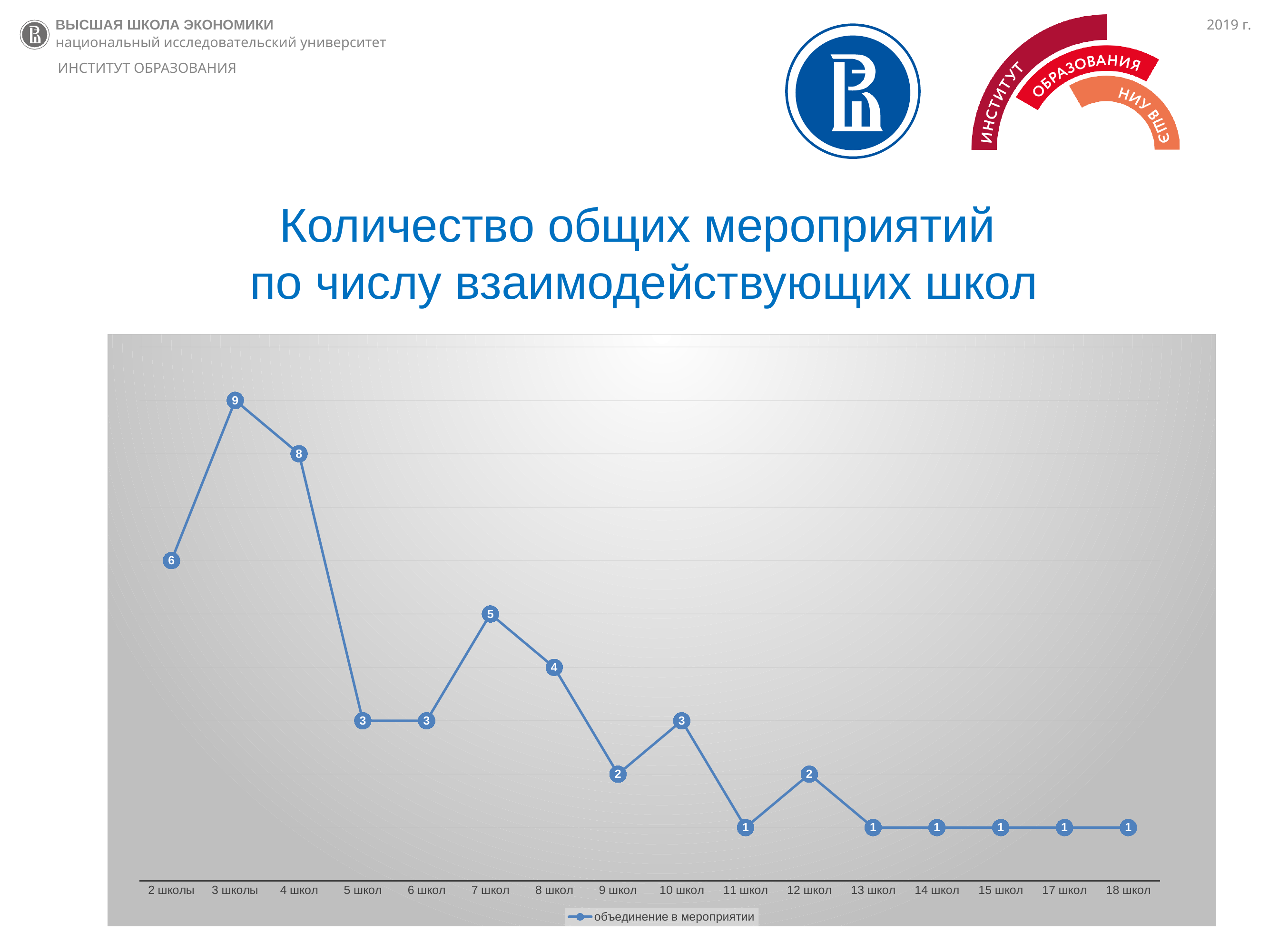
What is the value for "3 школы"? 9 Which category has the highest value? 3 школы How many categories are shown on the x axis? 16 What kind of chart is shown on the slide? line chart What is the legend entry for the series? объединение в мероприятии What is the difference between the values for "3 школы" and "4 школ"? 1 What is the value for "2 школы"? 6 Do the values generally rise or fall from "4 школ" to "18 школ"? fall How many series does the legend list? 1 What is the difference between the values for "2 школы" and "5 школ"? 3 Which is larger, the value for "8 школ" or the value for "10 школ"? 8 школ What is the value for "7 школ"? 5